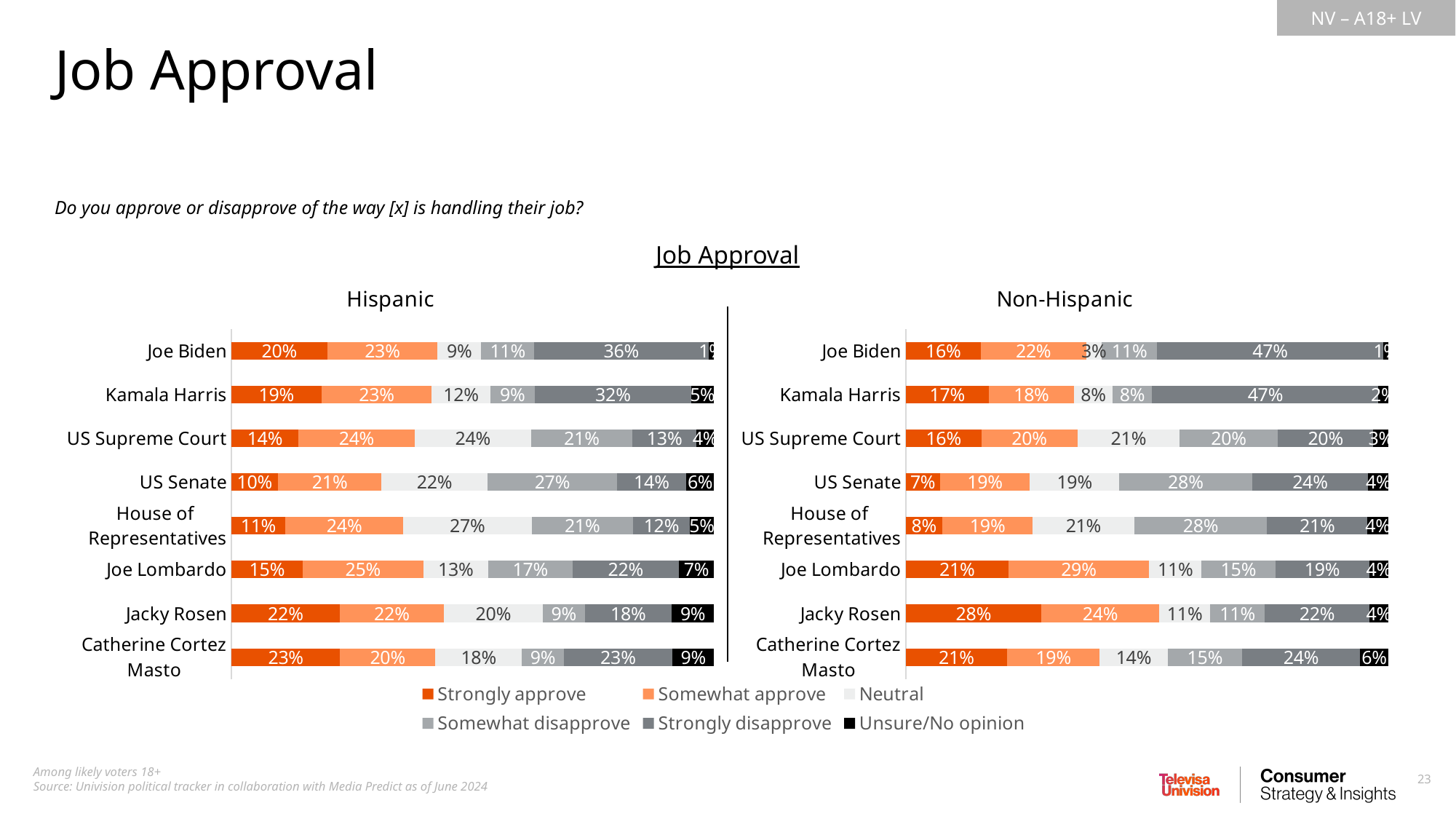
In the Hispanic chart, what is the Neutral value for the House of Representatives? 27% In the Non-Hispanic chart, what percentage strongly disapprove of Kamala Harris? 47% In the Hispanic chart, what percentage strongly approve of Joe Biden? 20% How many categories (people or institutions) are shown in the Hispanic chart? 8 In the Non-Hispanic chart, what is the combined Strongly approve and Somewhat approve value for Joe Lombardo? 50% What kind of chart is used to show the Non-Hispanic job approval data? Stacked bar chart In the Non-Hispanic chart, what is the difference between the Strongly disapprove values for Joe Biden and Joe Lombardo? 28% Which legend entry is shown in black? Unsure/No opinion In the Non-Hispanic chart, which category has the highest Strongly approve value? Jacky Rosen In the Hispanic chart, which category has the lowest Strongly approve value? US Senate In the Hispanic chart, which is larger: the Somewhat approve value for Joe Lombardo or for Jacky Rosen? Joe Lombardo How many series does the legend list? 6